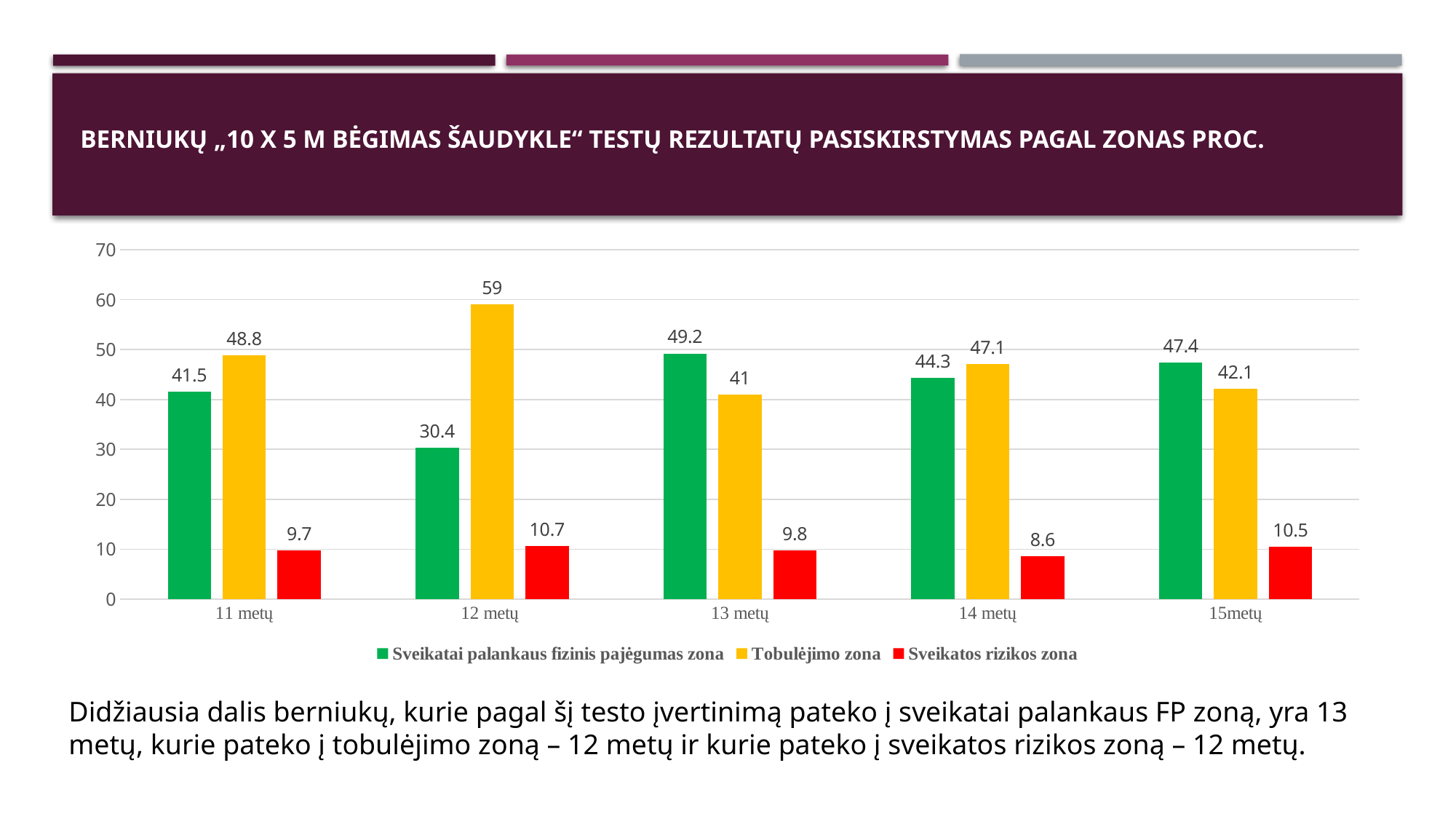
What is the value for 'Sveikatos rizikos zona' at 14 metų? 8.6 How many age groups are shown on the x axis? 5 Which age group has the highest value for 'Tobulėjimo zona'? 12 metų Which age group has the lowest value for 'Sveikatai palankaus fizinis pajėgumas zona'? 12 metų What is the value for 'Sveikatai palankaus fizinis pajėgumas zona' at 11 metų? 41.5 At 13 metų, which is larger: 'Sveikatai palankaus fizinis pajėgumas zona' or 'Tobulėjimo zona'? Sveikatai palankaus fizinis pajėgumas zona What is the difference between 'Tobulėjimo zona' and 'Sveikatai palankaus fizinis pajėgumas zona' at 12 metų? 28.6 What colour represents 'Sveikatos rizikos zona' in the chart? red What kind of chart is shown on the slide? bar chart Is the value for 'Sveikatos rizikos zona' at 12 metų greater or less than 10? greater What is the value for 'Tobulėjimo zona' at 12 metų? 59 How many series does the legend list? 3